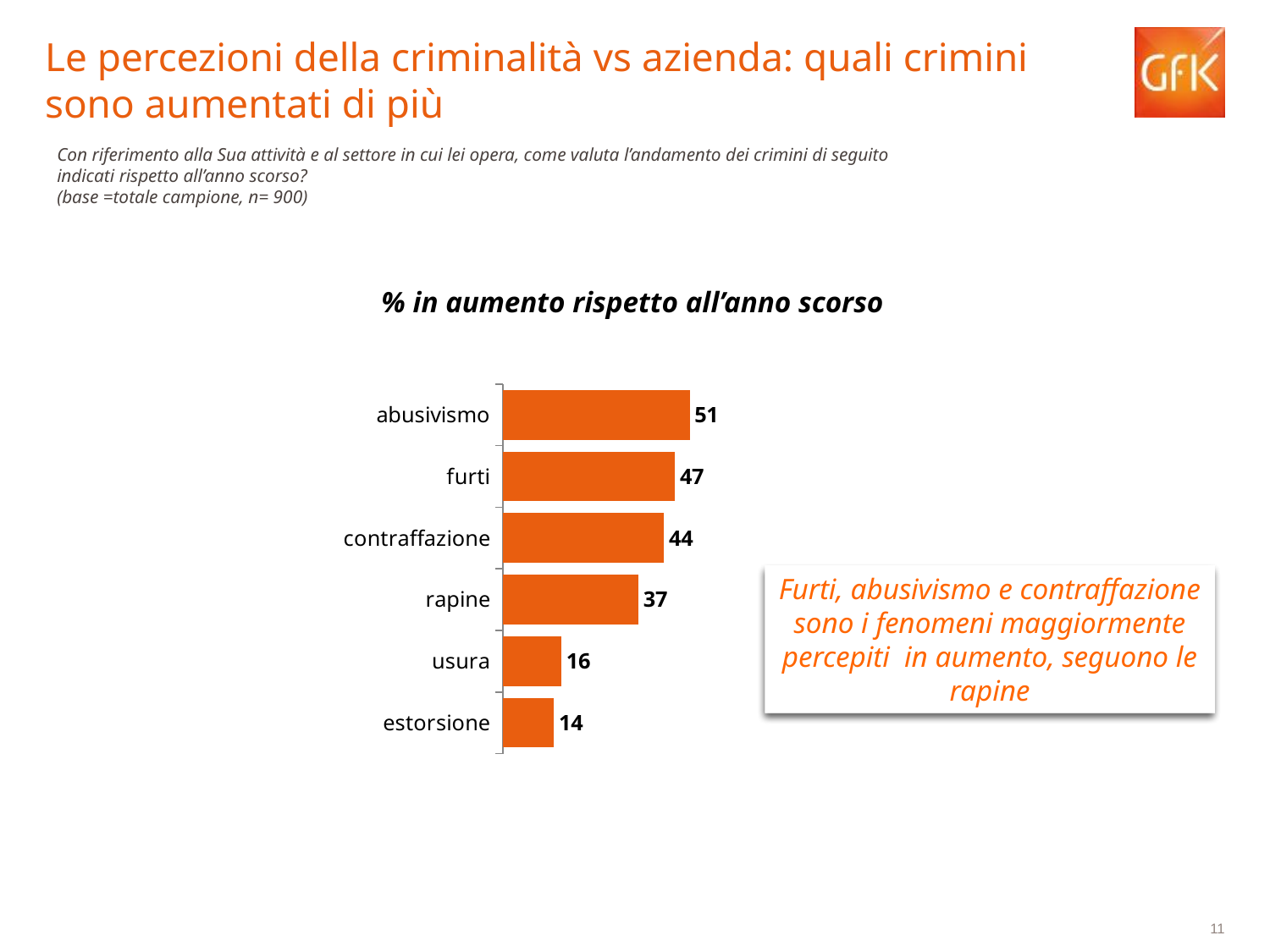
What is the value for abusivismo? 51 Which category has the highest value? abusivismo What kind of chart is shown on the slide? bar chart Which is larger, the value for rapine or the value for usura? rapine What is the value for estorsione? 14 What is the value for rapine? 37 How many categories are shown in the chart? 6 Which category has the lowest value? estorsione What is the difference between the values for abusivismo and usura? 35 What is the title of the chart? % in aumento rispetto all'anno scorso What colour are the bars in the chart? orange What is the difference between the values for furti and contraffazione? 3